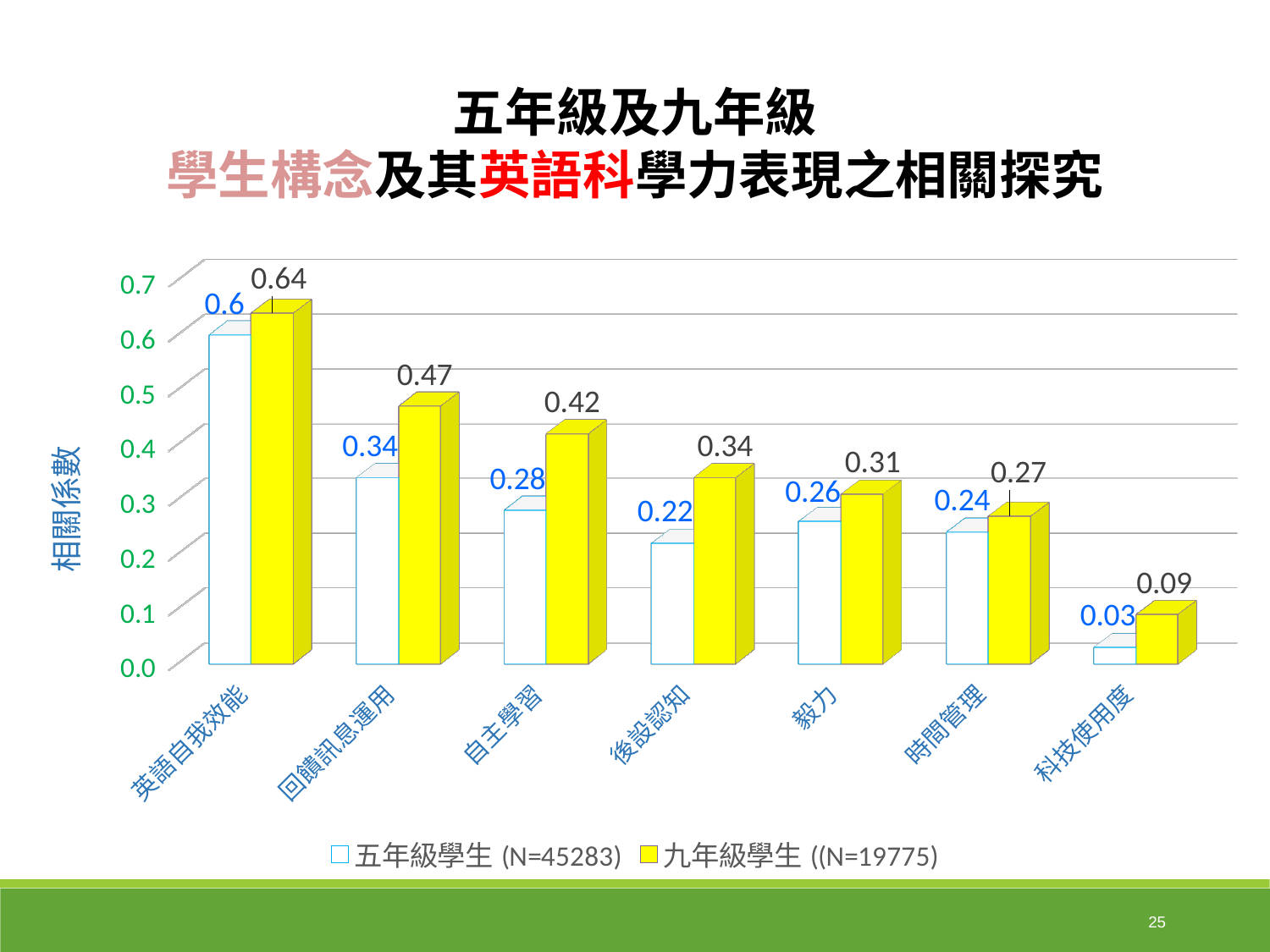
What kind of chart is shown on the slide? Bar chart Which category has the highest value for 九年級學生? 英語自我效能 Which category has the lowest value for 五年級學生? 科技使用度 Which is larger in the 毅力 category: the value for 五年級學生 or for 九年級學生? 九年級學生 What is the correlation coefficient for 五年級學生 in the 英語自我效能 category? 0.6 What is the difference between the 九年級學生 and 五年級學生 values in the 自主學習 category? 0.14 What is the correlation coefficient for 九年級學生 in the 回饋訊息運用 category? 0.47 What is the label of the y axis? 相關係數 Do the 九年級學生 values rise or fall from 英語自我效能 to 科技使用度 along the x axis? Fall How many categories are shown on the x axis? 7 What is the value for 五年級學生 in the 後設認知 category? 0.22 How many series does the legend list? 2